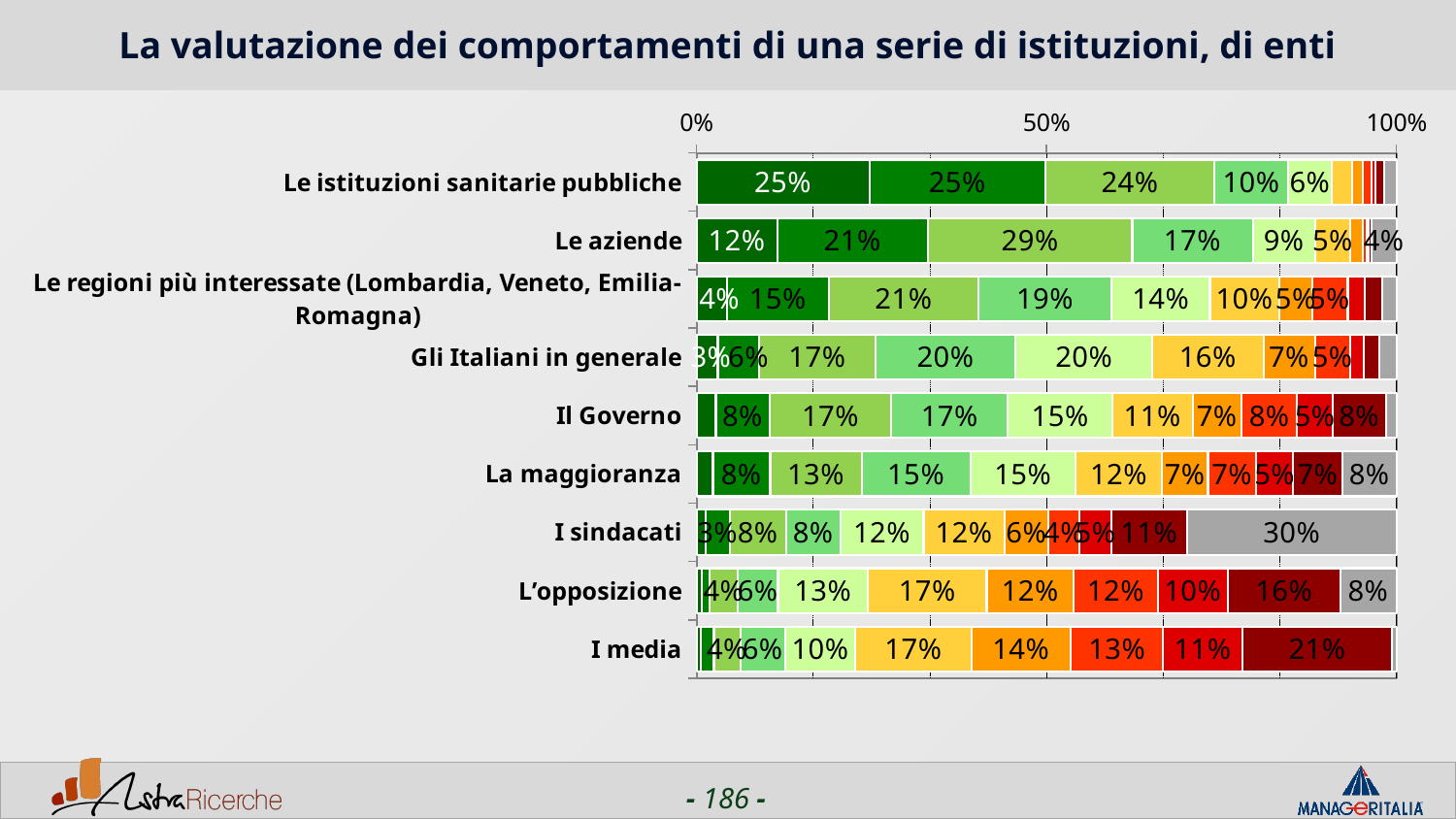
What is the value of the largest segment in the bar for 'Le aziende'? 29% What is the value of the grey segment at the end of the bar for 'I sindacati'? 30% What is the value of the first (darkest green) segment for 'Le istituzioni sanitarie pubbliche'? 25% What kind of chart is shown on the slide? Stacked bar chart What is the title of the slide? La valutazione dei comportamenti di una serie di istituzioni, di enti Which is larger: the dark red segment for 'I media' or the dark red segment for 'L'opposizione'? I media What is the value of the dark red segment for 'L'opposizione'? 16% Which category has the largest first (darkest green) segment? Le istituzioni sanitarie pubbliche Which category has the largest grey (final) segment? I sindacati What is the difference between the grey segment for 'I sindacati' (30%) and the grey segment for 'L'opposizione' (8%)? 22% What is the value of the dark red segment at the end of the bar for 'I media'? 21% How many institutions (categories) are listed on the chart? 9